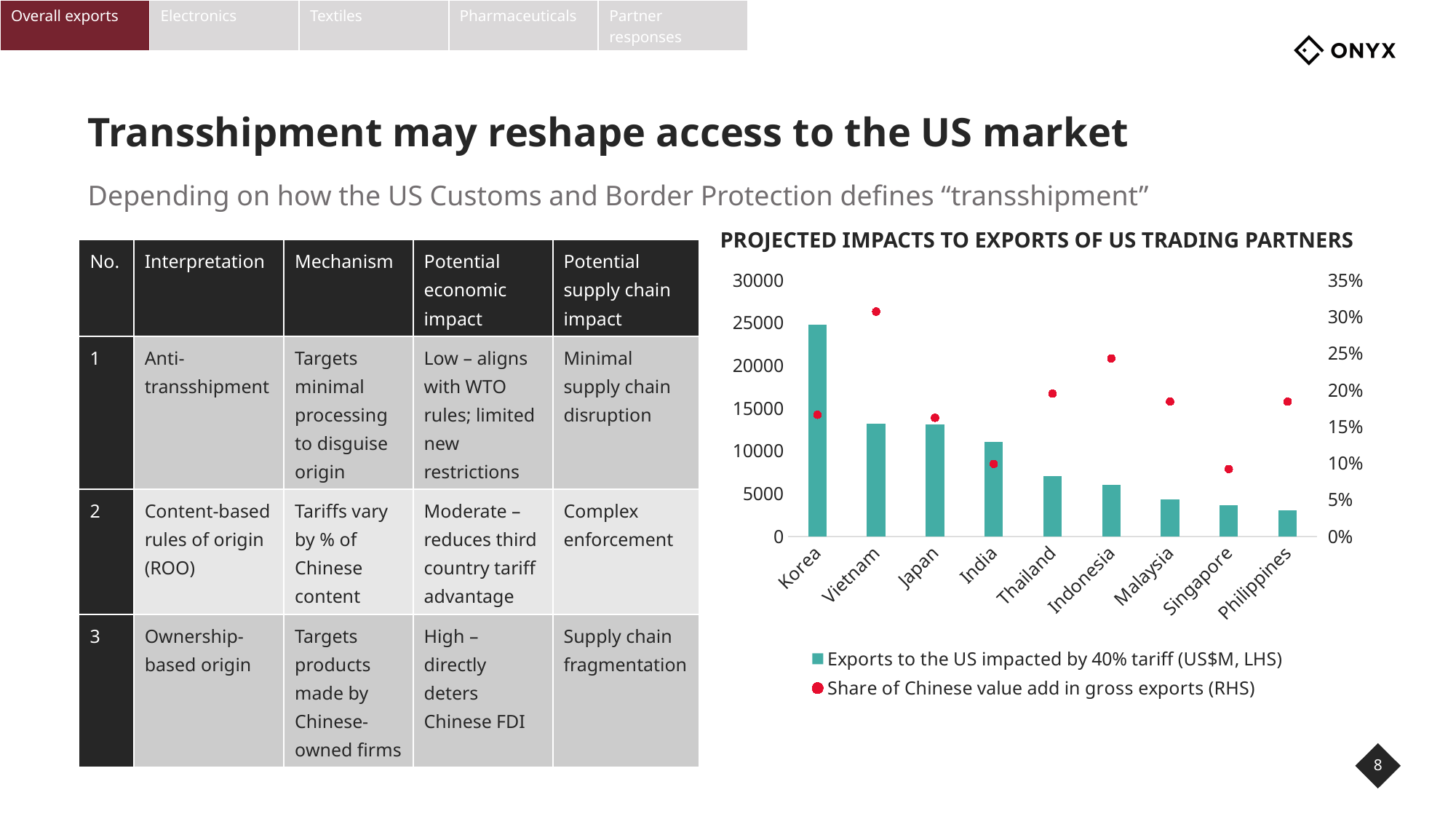
What kind of chart is used to show exports to the US impacted by the 40% tariff? bar chart Which country has the highest share of Chinese value add in gross exports? Vietnam How many series does the chart's legend list? 2 How many countries are shown on the x axis of the chart? 9 Is the share of Chinese value add in gross exports for Vietnam greater or less than 25%? greater Do the bars for exports to the US impacted by the 40% tariff rise or fall from left to right across the x axis? fall Which has a larger value for exports to the US impacted by the 40% tariff, Korea or Vietnam? Korea Which country has the lowest value for exports to the US impacted by the 40% tariff? Philippines Is the value of exports to the US impacted by the 40% tariff for Korea greater or less than 20000? greater Is the value of exports to the US impacted by the 40% tariff for Thailand greater or less than 10000? less Which country has the highest value for exports to the US impacted by the 40% tariff? Korea What is the title of the chart on the slide? PROJECTED IMPACTS TO EXPORTS OF US TRADING PARTNERS